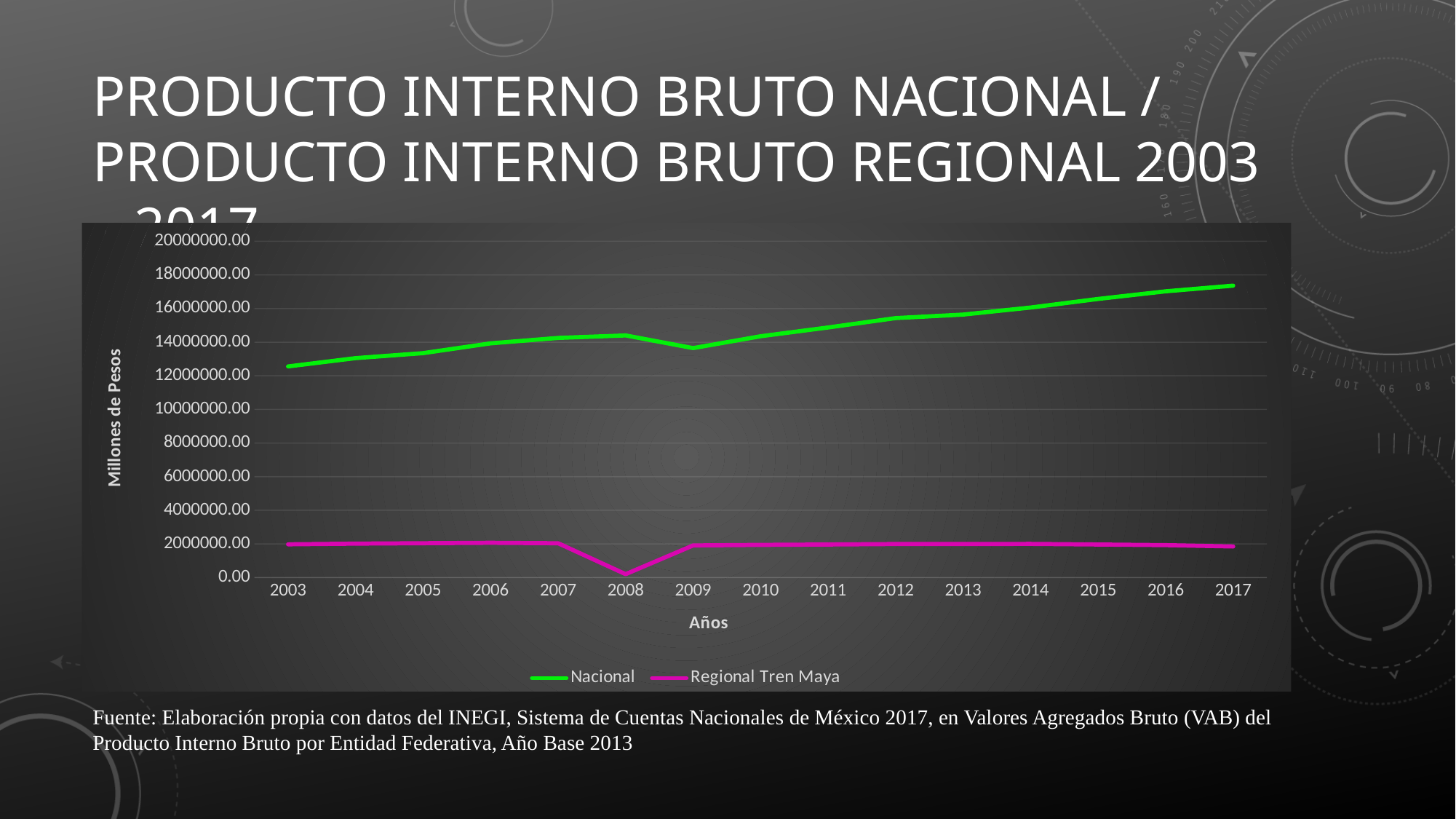
Does the Nacional series rise or fall between 2008 and 2009? fall What kind of chart is shown on the slide? line chart What is the label of the y axis? Millones de Pesos Is the Nacional value for 2017 greater or less than 16000000.00? greater Which series has the larger value in 2010, Nacional or Regional Tren Maya? Nacional In which year is the Nacional series at its lowest? 2003 How many years are shown on the x axis? 15 In which year is the Regional Tren Maya series at its lowest? 2008 Is the Regional Tren Maya value for 2008 greater or less than 2000000.00? less How many series does the legend list? 2 Is the Nacional value for 2009 greater or less than 14000000.00? less In which year is the Nacional series at its highest? 2017